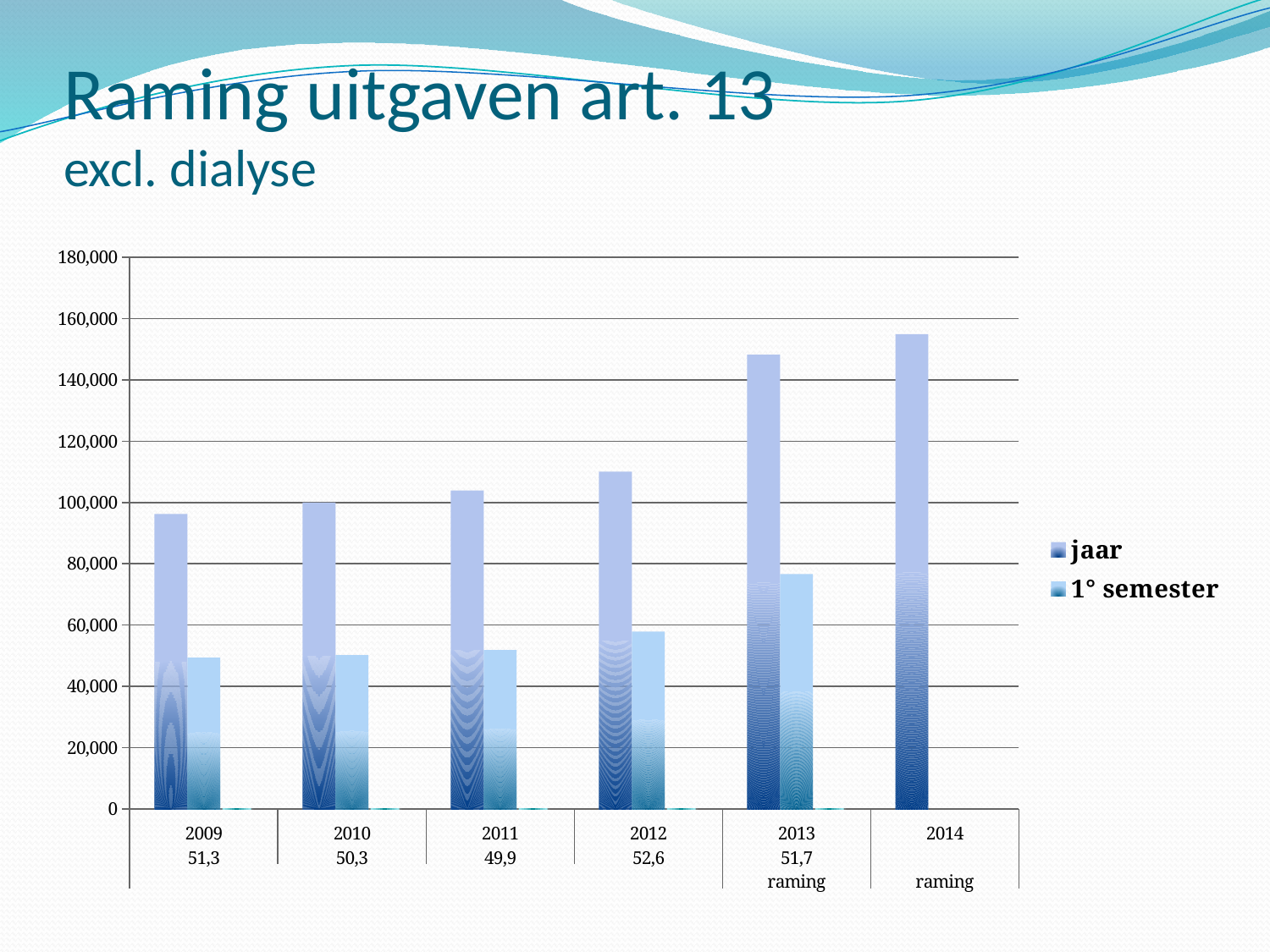
What kind of chart is shown on the slide? bar chart Is the 'jaar' value for 2009 greater or less than 100,000? less Is the '1° semester' value for 2013 greater or less than 60,000? greater Which year has the lowest 'jaar' bar? 2009 How many series does the legend list? 2 How many year categories are shown on the x axis? 6 Which year has the highest '1° semester' bar? 2013 Which year has the highest 'jaar' bar? 2014 Is the 'jaar' value for 2013 greater or less than 140,000? greater Which is larger, the 'jaar' value for 2012 or for 2013? 2013 Do the 'jaar' values rise or fall from 2009 to 2014? rise